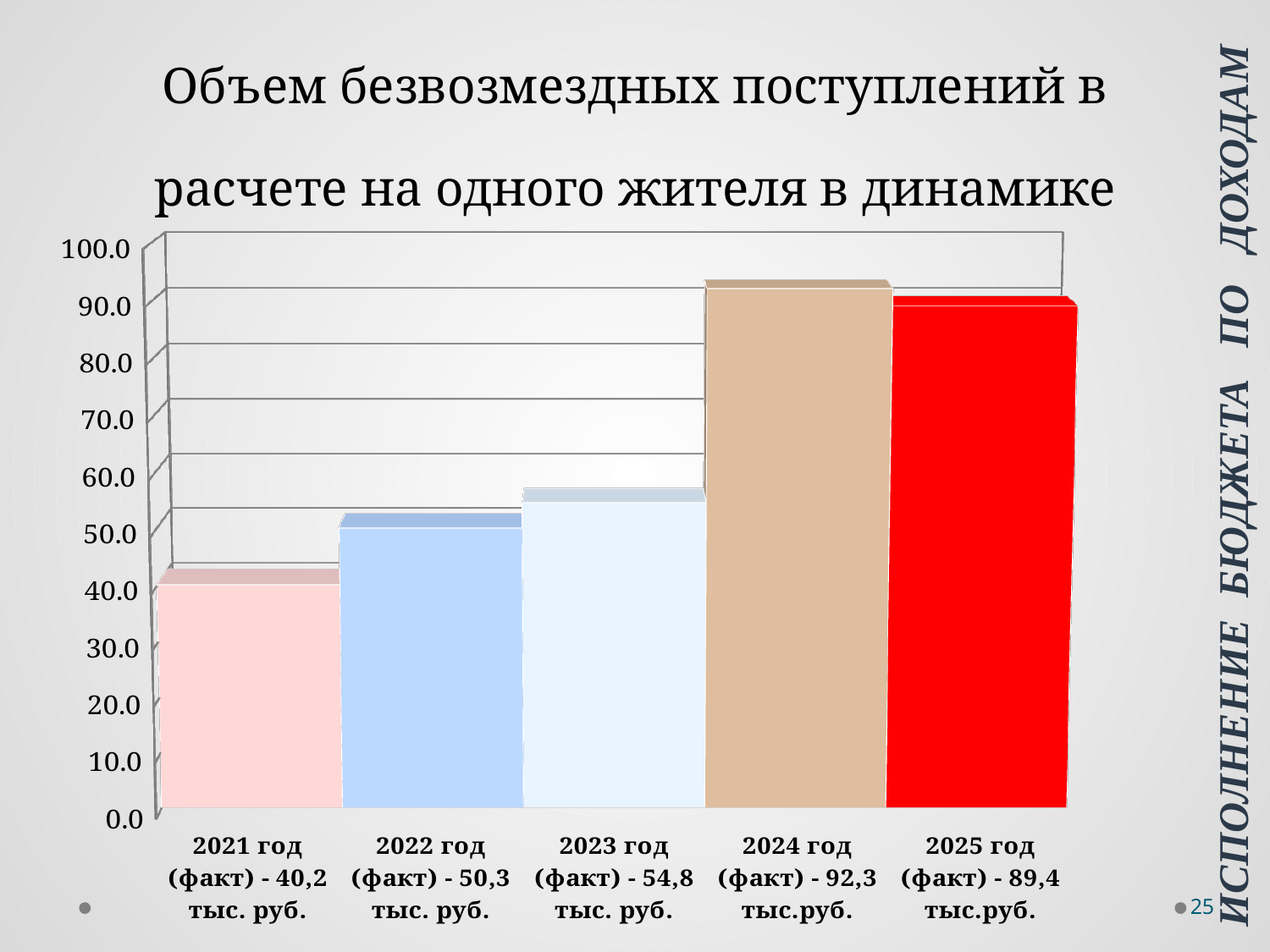
Is the value for 2023 год greater or less than 60.0? less What is the difference between the values for 2022 год and 2021 год? 10,1 тыс. руб. What is the difference between the values for 2024 год and 2025 год? 2,9 тыс. руб. Which year has the lowest value? 2021 год Do the values rise or fall from 2021 год to 2024 год? rise What kind of chart is shown on the slide? bar chart What is the value for 2025 год? 89,4 тыс.руб. What is the value for 2021 год? 40,2 тыс. руб. Which is larger, the value for 2023 год or the value for 2022 год? 2023 год What is the value for 2024 год? 92,3 тыс.руб. How many years are shown on the chart? 5 Which year has the highest value? 2024 год